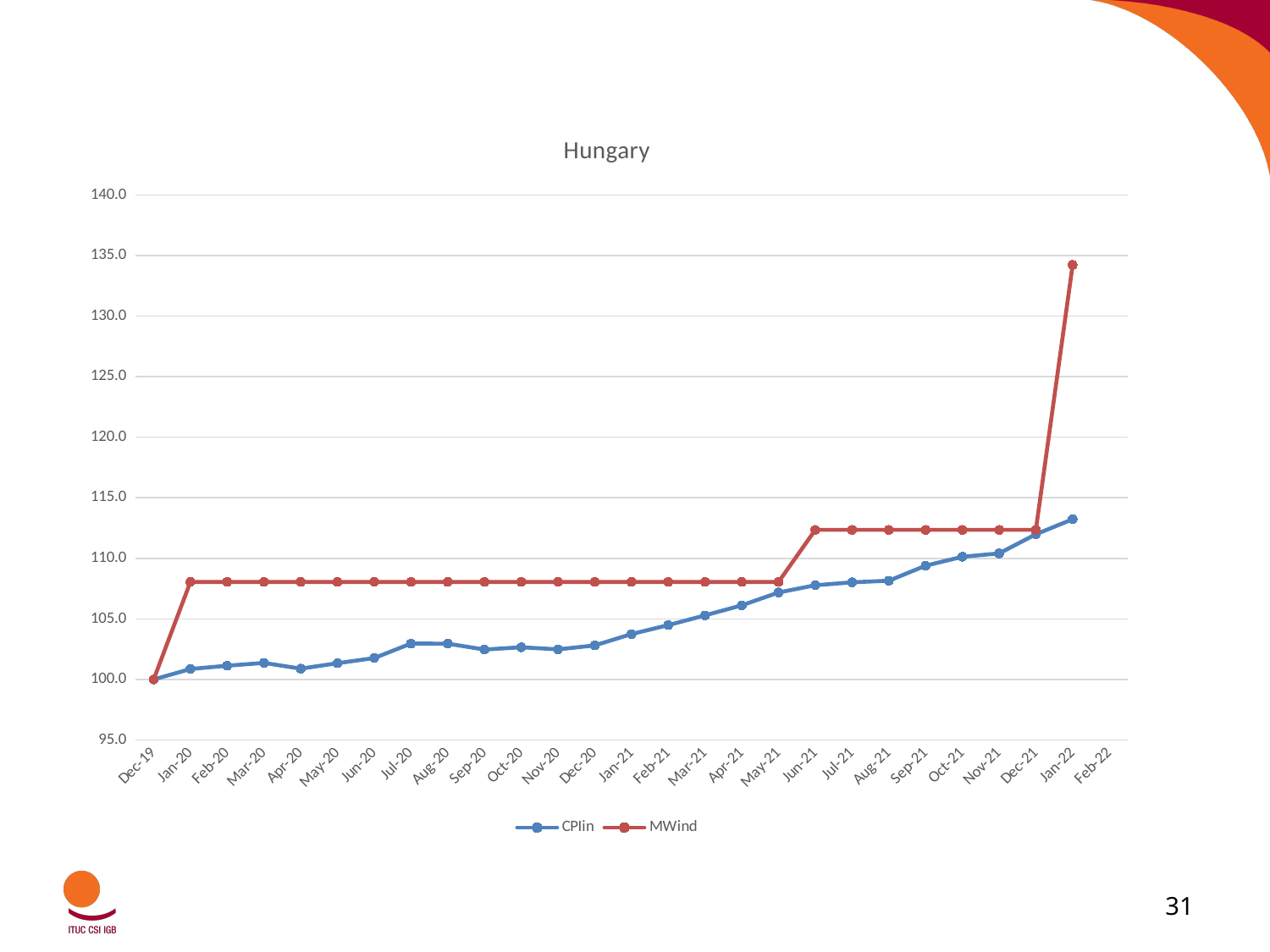
What is the value of CPIin at Dec-19? 100.0 Is the value for MWind at Mar-20 greater or less than 105? greater What is the title of the chart? Hungary What kind of chart is shown on the slide? Line chart Is the value for CPIin at Jul-20 greater or less than 105? less Does the CPIin series generally rise or fall from Dec-19 to Jan-22? Rise At Jun-21, which series has the larger value, CPIin or MWind? MWind Which series is drawn in red? MWind How many series does the legend list? 2 Is the value for CPIin at Jan-22 greater or less than 115? less In which month does MWind reach its highest value? Jan-22